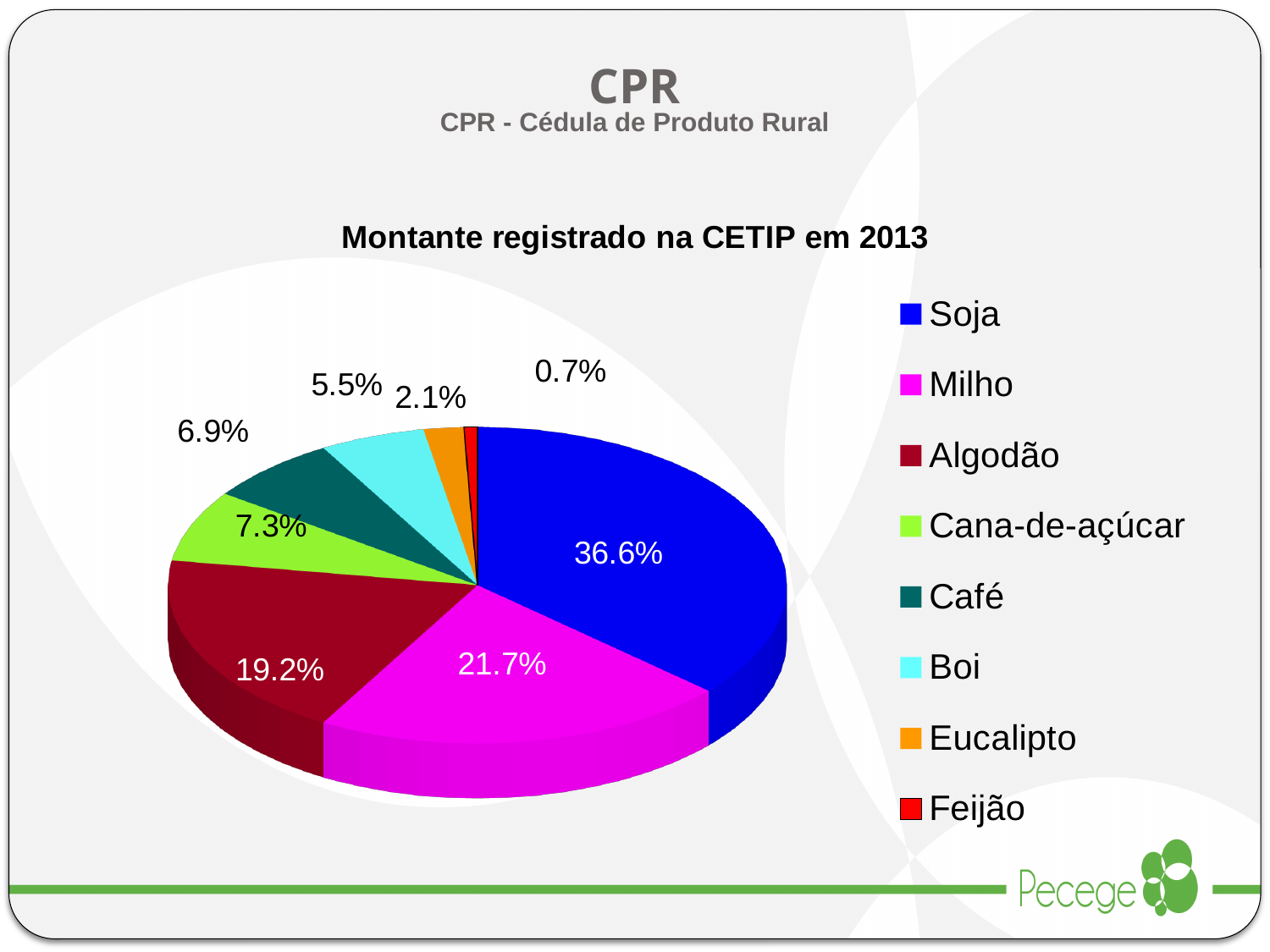
What is the value shown for Eucalipto? 2.1% What is the value shown for Algodão? 19.2% What is the value shown for Café? 6.9% What is the value shown for Cana-de-açúcar? 7.3% Which category has the smallest slice of the pie? Feijão What type of chart is shown on the slide? pie chart How many categories does the legend list? 8 What is the difference between the shares of Soja and Milho? 14.9% What share of the pie does Soja represent? 36.6% What is the title of the chart? Montante registrado na CETIP em 2013 Which category has the largest slice of the pie? Soja What share of the pie does Milho represent? 21.7%